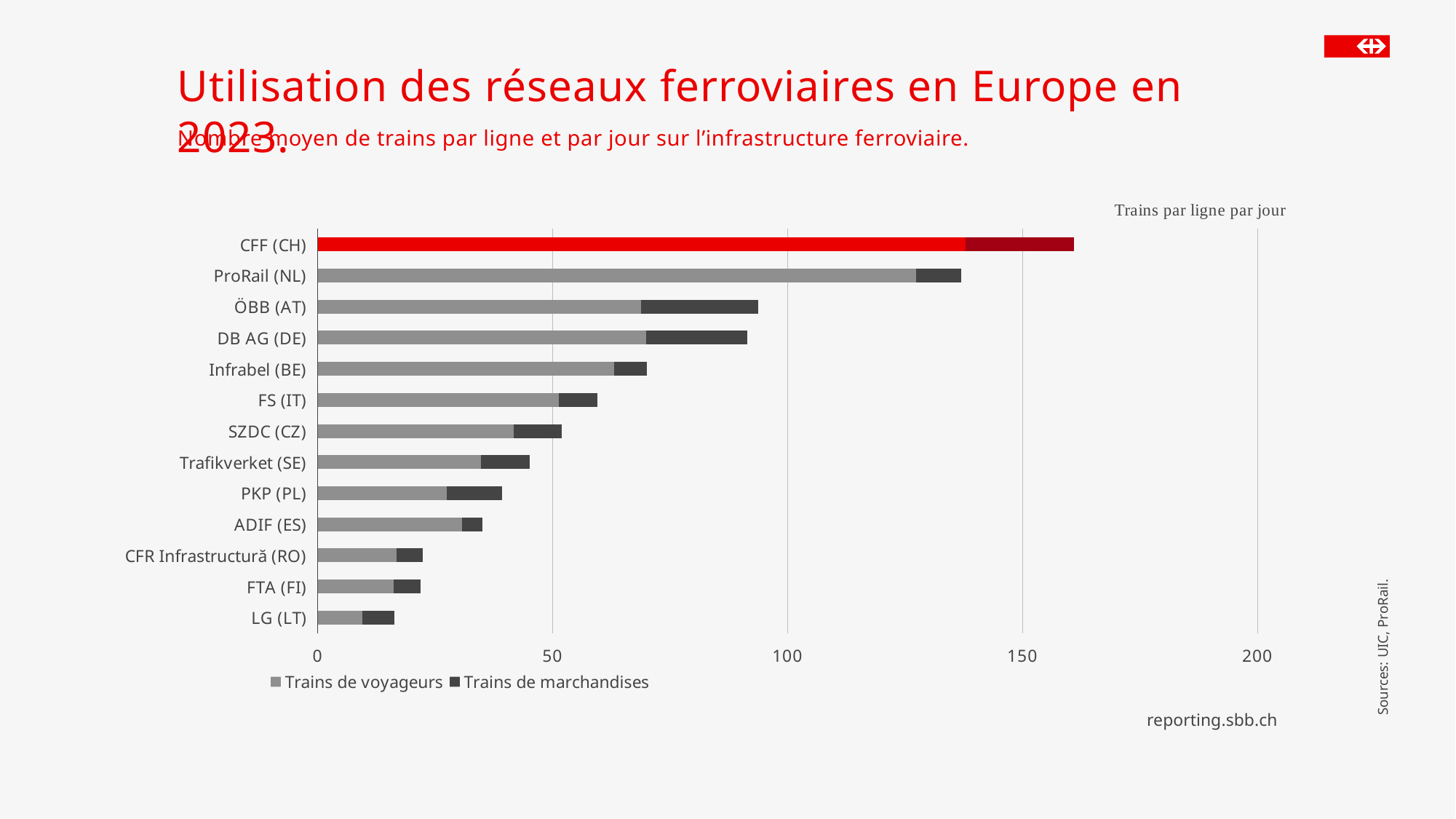
Which operator has the lowest total number of trains per line per day? LG (LT) Which has a larger total, Infrabel (BE) or FS (IT)? Infrabel (BE) Is the total value for Trafikverket (SE) greater or less than 50? less Is the total value for CFF (CH) greater or less than 150? greater How many series does the legend list? 2 Is the total value for ÖBB (AT) greater or less than 100? less What are the two series named in the legend? Trains de voyageurs and Trains de marchandises How many railway operators (categories) are shown in the chart? 13 What kind of chart is shown on the slide? bar chart Which operator has the highest total number of trains per line per day? CFF (CH)